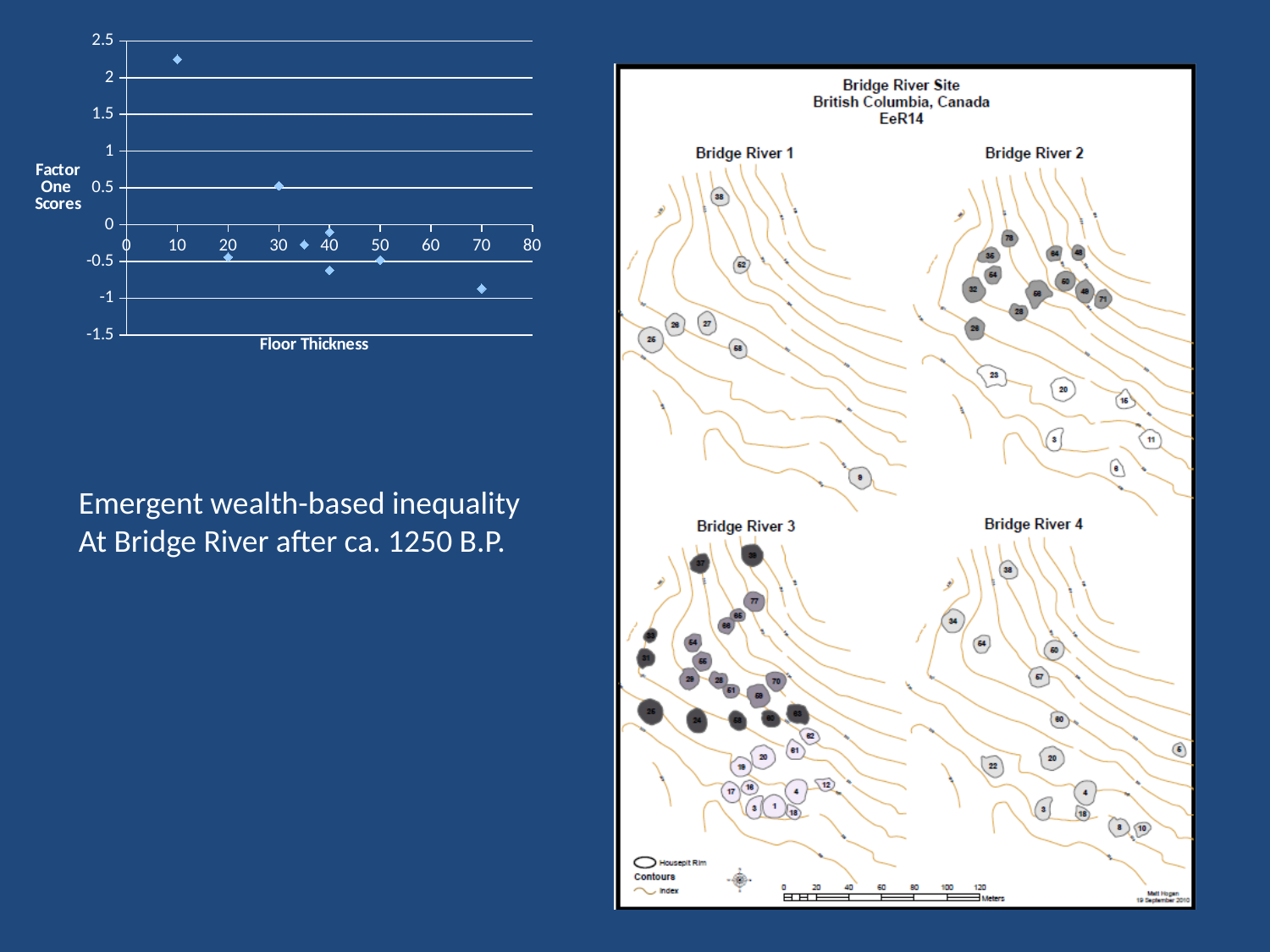
Which has the larger Factor One Score: the point at floor thickness 10 or the point at floor thickness 70? The point at floor thickness 10 What is the highest value shown on the vertical axis of the scatter chart? 2.5 What is the title of the vertical axis of the scatter chart? Factor One Scores Overall, do Factor One Scores rise or fall as floor thickness increases in the scatter chart? Fall Is the Factor One Score for the point at floor thickness 70 greater or less than -0.5? less Is the Factor One Score for the point at floor thickness 10 greater or less than 2? greater At which floor thickness value does the scatter chart show the highest Factor One Score? 10 Is the Factor One Score for the point at floor thickness 30 greater or less than 0? greater What kind of chart is shown on the left of the slide? Scatter chart At which floor thickness value does the scatter chart show the lowest Factor One Score? 70 What is the title of the horizontal axis of the scatter chart? Floor Thickness